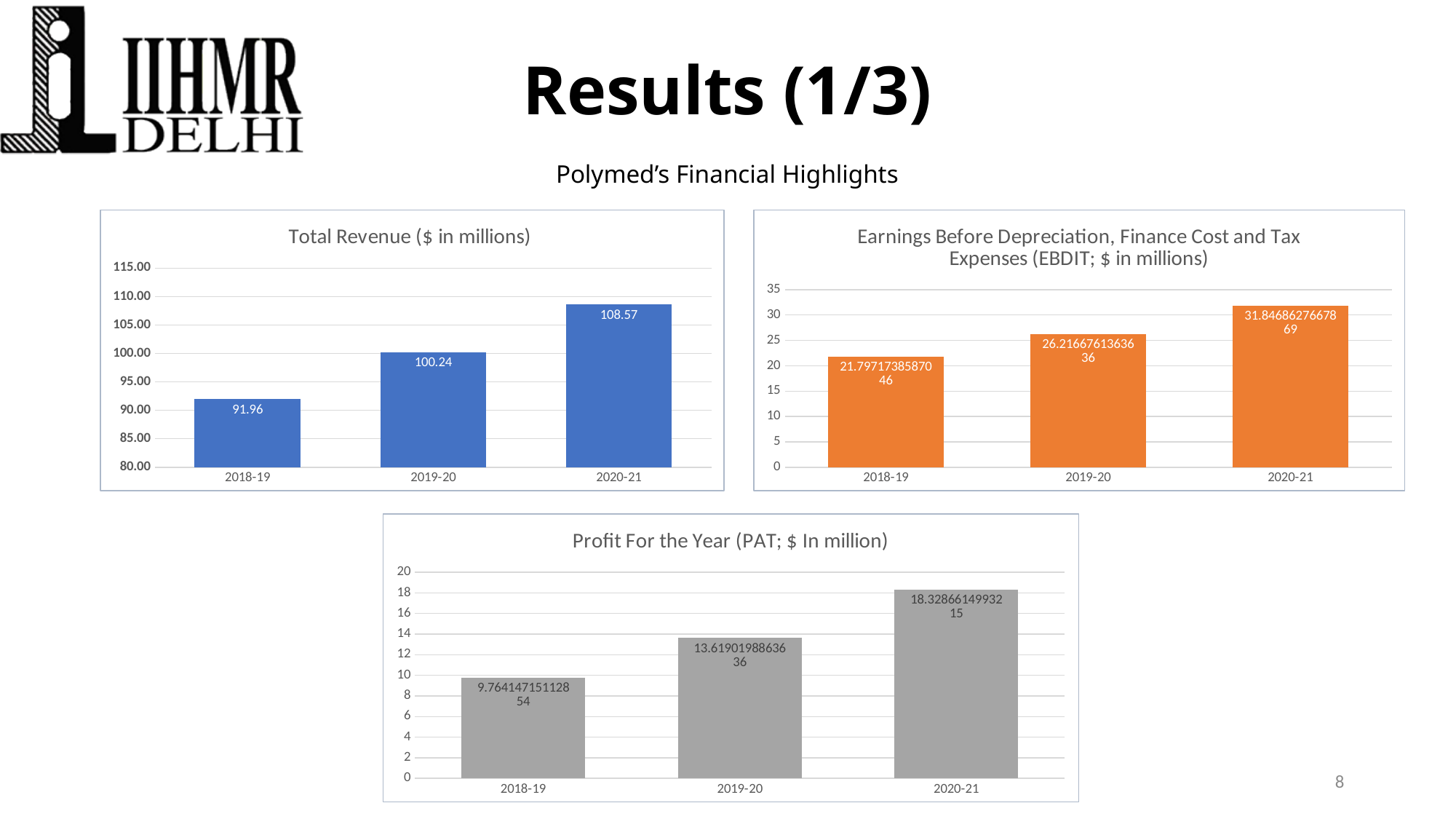
In the Earnings Before Depreciation, Finance Cost and Tax Expenses chart, what is the value for 2018-19? 21.7971738587046 In the Profit For the Year chart, what is the value for 2020-21? 18.3286614993215 In the Total Revenue chart, what is the value for 2019-20? 100.24 How many years are shown on the x axis of the Profit For the Year chart? 3 What type of chart is the Total Revenue chart? bar chart In the Profit For the Year chart, do the values rise or fall from 2018-19 to 2020-21? rise In the Earnings Before Depreciation, Finance Cost and Tax Expenses chart, is the value for 2019-20 greater or less than 25? greater In the Earnings Before Depreciation, Finance Cost and Tax Expenses chart, which year has the highest value? 2020-21 In the Total Revenue chart, what is the value for 2020-21? 108.57 In the Total Revenue chart, which year has the lowest value? 2018-19 In the Profit For the Year chart, is the value for 2018-19 greater or less than 10? less In the Total Revenue chart, what is the difference between the 2020-21 and 2018-19 values? 16.61